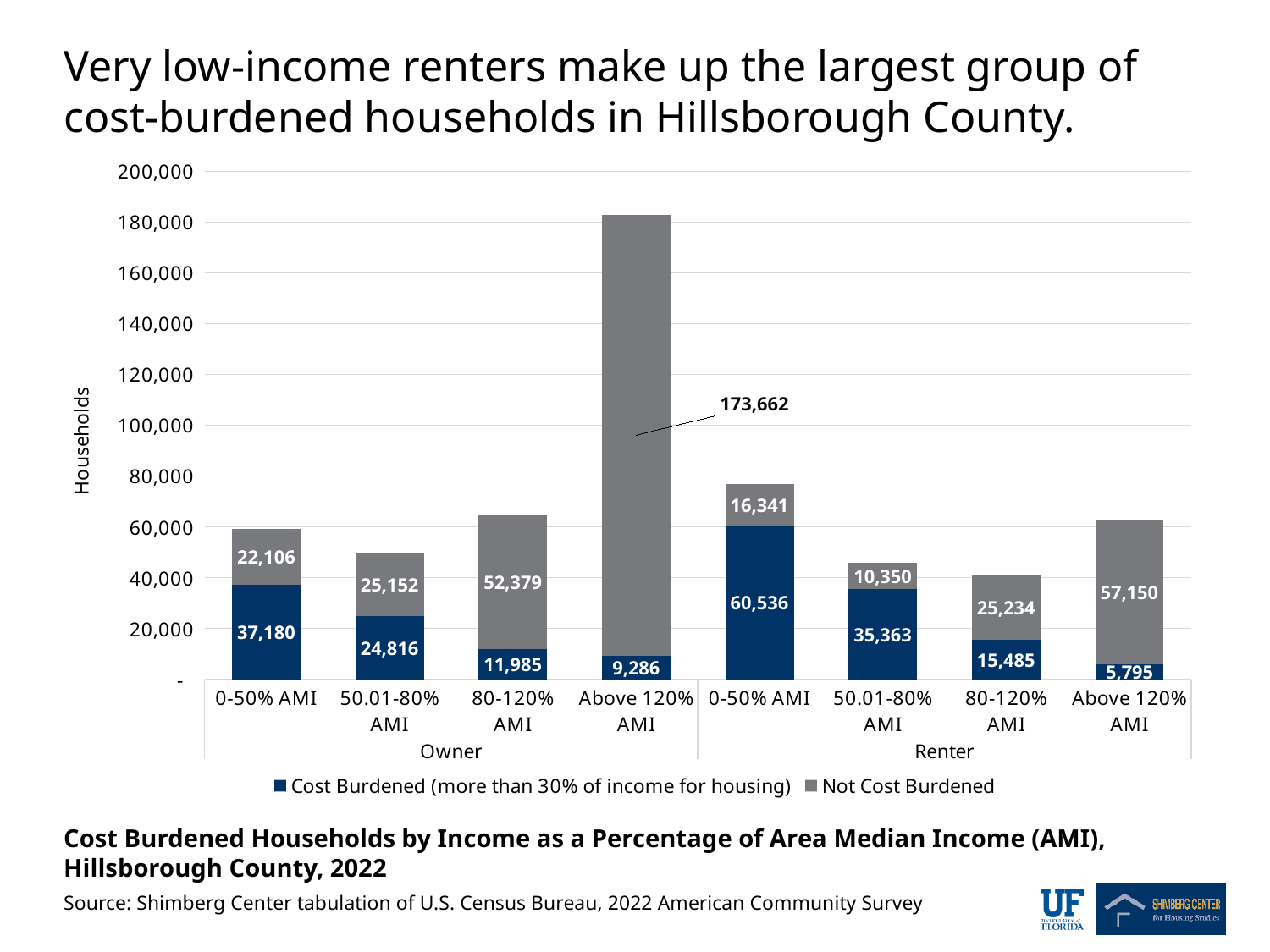
How many series does the legend list? 2 Which is larger: the number of cost-burdened owner households at 80-120% AMI or cost-burdened renter households at 80-120% AMI? Renter 80-120% AMI (15,485) What is the total number of households in the Owner 0-50% AMI bar? 59,286 How many not-cost-burdened owner households are in the Above 120% AMI group? 173,662 How many cost-burdened owner households are in the 50.01-80% AMI group? 24,816 How many cost-burdened renter households are in the 0-50% AMI group? 60,536 Which group has the smallest number of cost-burdened households? Renter Above 120% AMI What is the difference between cost-burdened renter households and cost-burdened owner households in the 0-50% AMI group? 23,356 Which group has the largest number of cost-burdened households? Renter 0-50% AMI How many income groups (bars) are shown on the chart? 8 What type of chart is shown on the slide? Stacked bar chart What is the total number of households in the Renter 0-50% AMI bar? 76,877